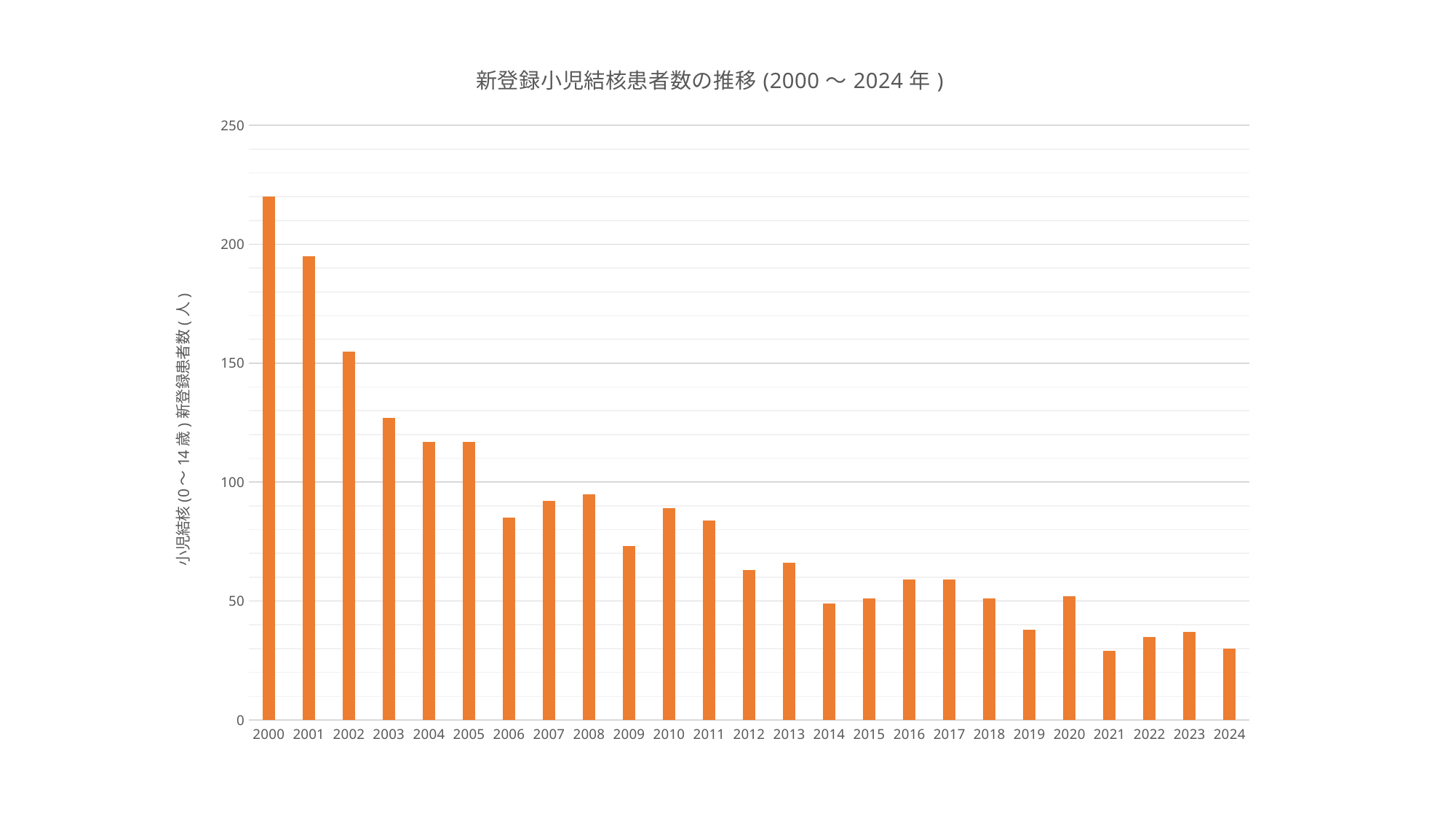
Which year has the highest number of newly registered pediatric tuberculosis patients? 2000 Which is larger, the value for 2001 or the value for 2002? 2001 Is the value for 2006 greater or less than 100? less Is the value for 2000 greater or less than 200? greater Which is larger, the value for 2008 or the value for 2009? 2008 Is the value for 2021 greater or less than 50? less Overall, do the values rise or fall from 2000 to 2024? fall What is the title of the chart? 新登録小児結核患者数の推移 (2000 〜 2024 年 ) How many years (bars) are plotted in the chart? 25 What kind of chart is shown on the slide? Bar chart